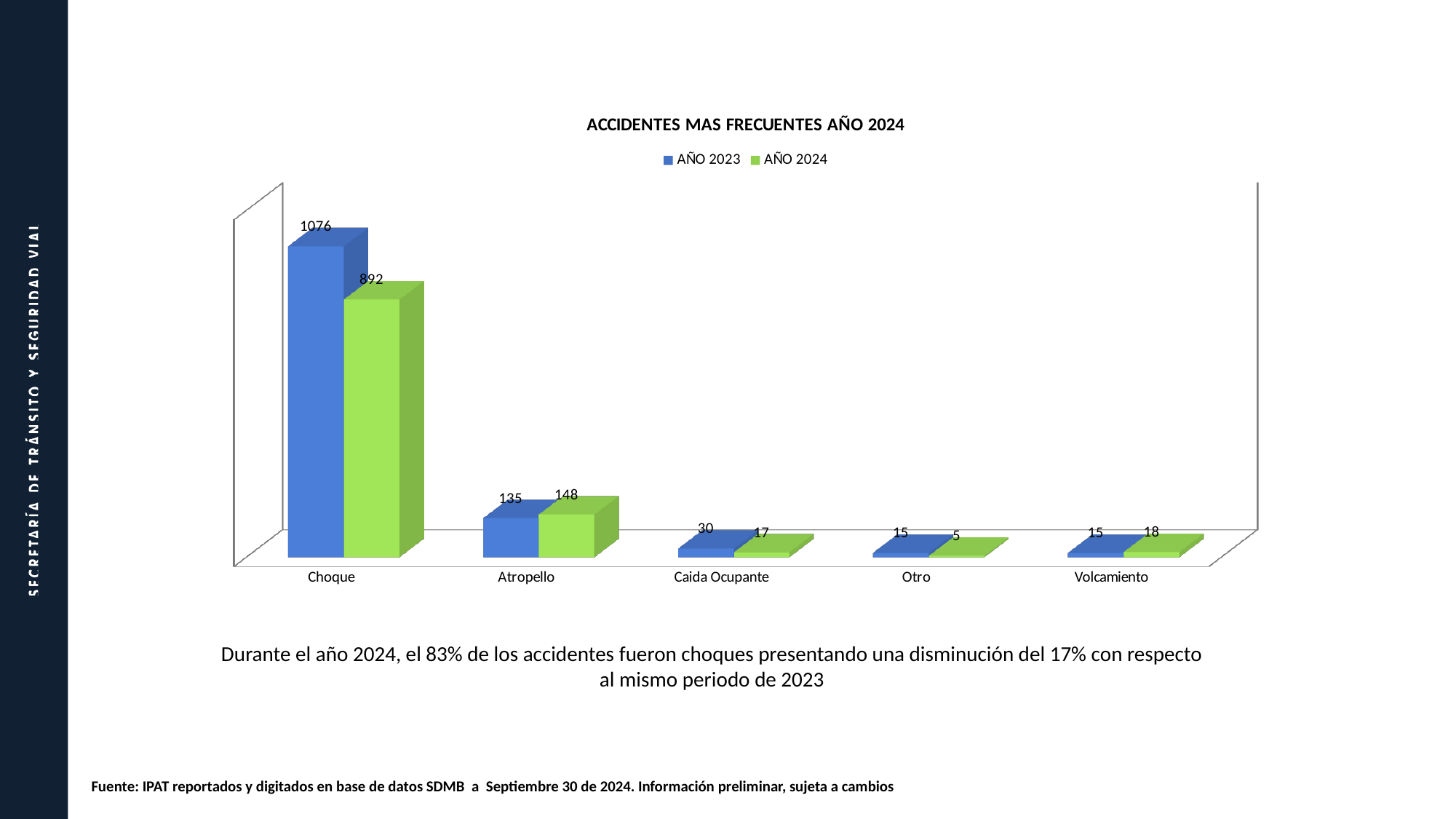
How many categories are shown on the x axis? 5 What is the difference between the AÑO 2023 and AÑO 2024 values for Choque? 184 What kind of chart is shown on the slide? Bar chart For Atropello, which series has the larger value, AÑO 2023 or AÑO 2024? AÑO 2024 Which category has the lowest value in the AÑO 2024 series? Otro What is the value for Choque in the AÑO 2023 series? 1076 Which category has the highest value in the AÑO 2023 series? Choque What is the value for Choque in the AÑO 2024 series? 892 What is the value for Otro in the AÑO 2024 series? 5 How many series does the legend list? 2 What is the title of the chart? ACCIDENTES MAS FRECUENTES AÑO 2024 What is the value for Atropello in the AÑO 2024 series? 148